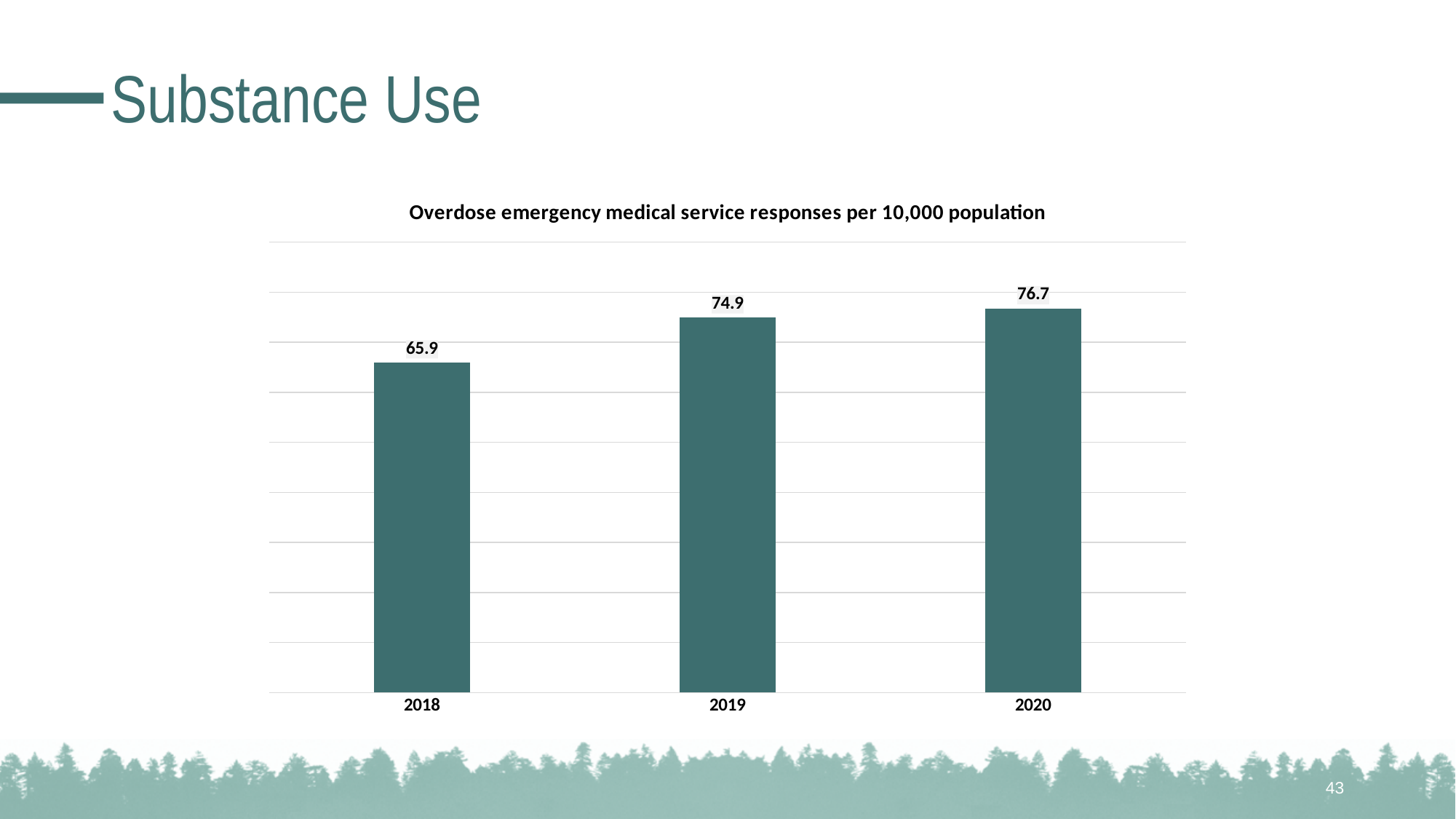
What is the value for 2018? 65.9 What kind of chart is this? bar chart What is the difference between the values for 2019 and 2018? 9.0 How many years are shown on the chart? 3 Which year has the highest value? 2020 What is the difference between the values for 2020 and 2018? 10.8 Do the values rise or fall from 2018 to 2020? rise Which year has the lowest value? 2018 Which is larger, the value for 2018 or the value for 2019? 2019 What is the title of the chart? Overdose emergency medical service responses per 10,000 population What is the value for 2020? 76.7 What is the value for 2019? 74.9